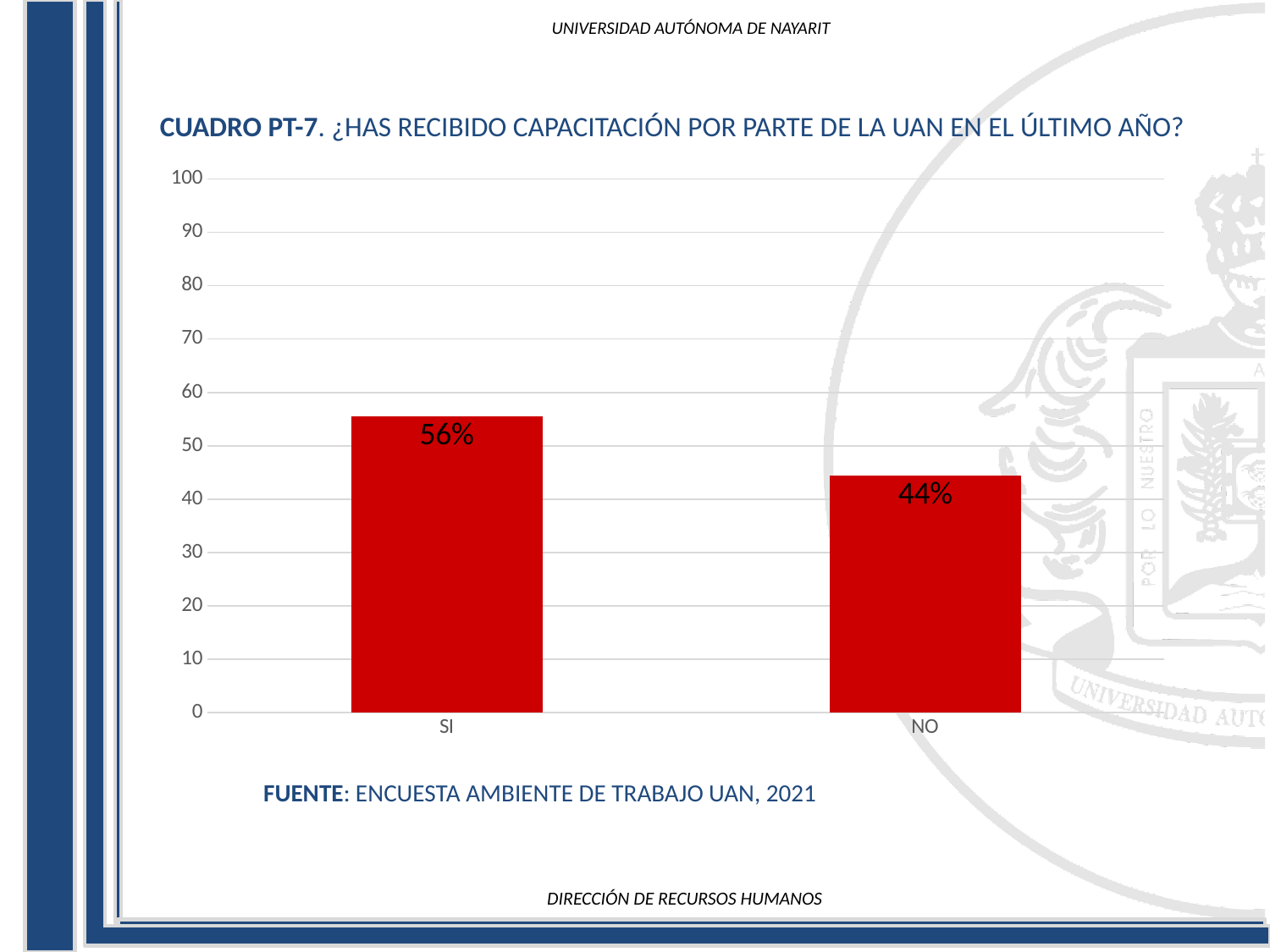
Is the value for SI greater or less than 50? greater Is the value for NO greater or less than 50? less What kind of chart is shown on the slide? bar chart What is the source cited below the chart? ENCUESTA AMBIENTE DE TRABAJO UAN, 2021 Which is larger, the value for SI or the value for NO? SI What is the value for SI? 56% Which category has the lowest value? NO What is the difference between the values for SI and NO? 12% How many categories are shown on the x axis? 2 Which category has the highest value? SI What is the value for NO? 44% What colour are the bars in the chart? red